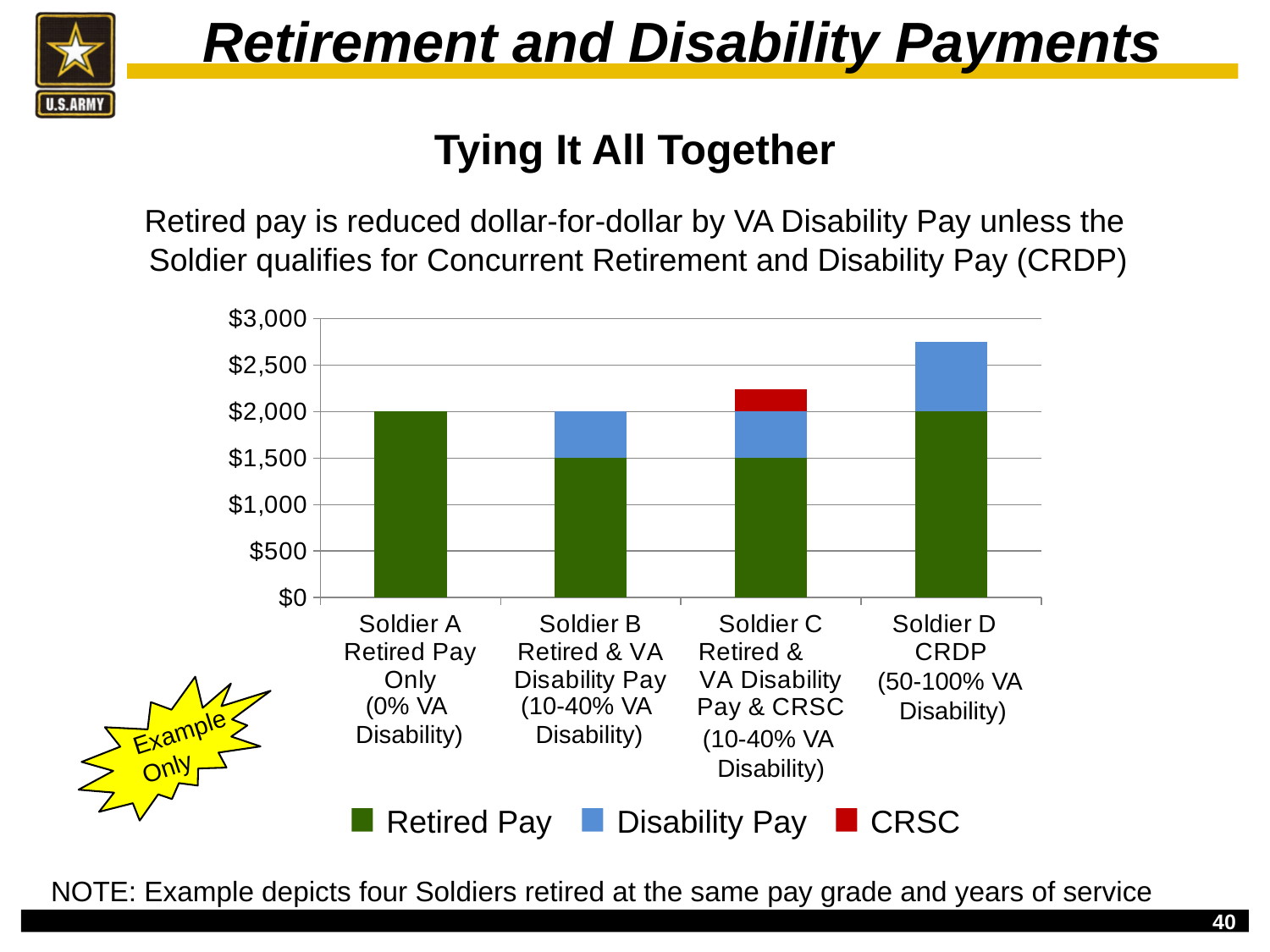
What is the Retired Pay value for Soldier A? $2,000 Is the total bar for Soldier C greater or less than $2,500? less Which series is shown in red in the chart legend? CRSC What is the Retired Pay value for Soldier B? $1,500 Which has a larger total bar, Soldier C or Soldier D? Soldier D What is the total height of the stacked bar for Soldier B? $2,000 How many soldiers (categories) are shown on the x axis of the chart? 4 How many series does the chart legend list? 3 What is the Retired Pay value for Soldier D? $2,000 Is the total bar for Soldier D greater or less than $2,500? greater What kind of chart is shown on the slide? Stacked bar chart Which soldier has the highest total stacked bar? Soldier D